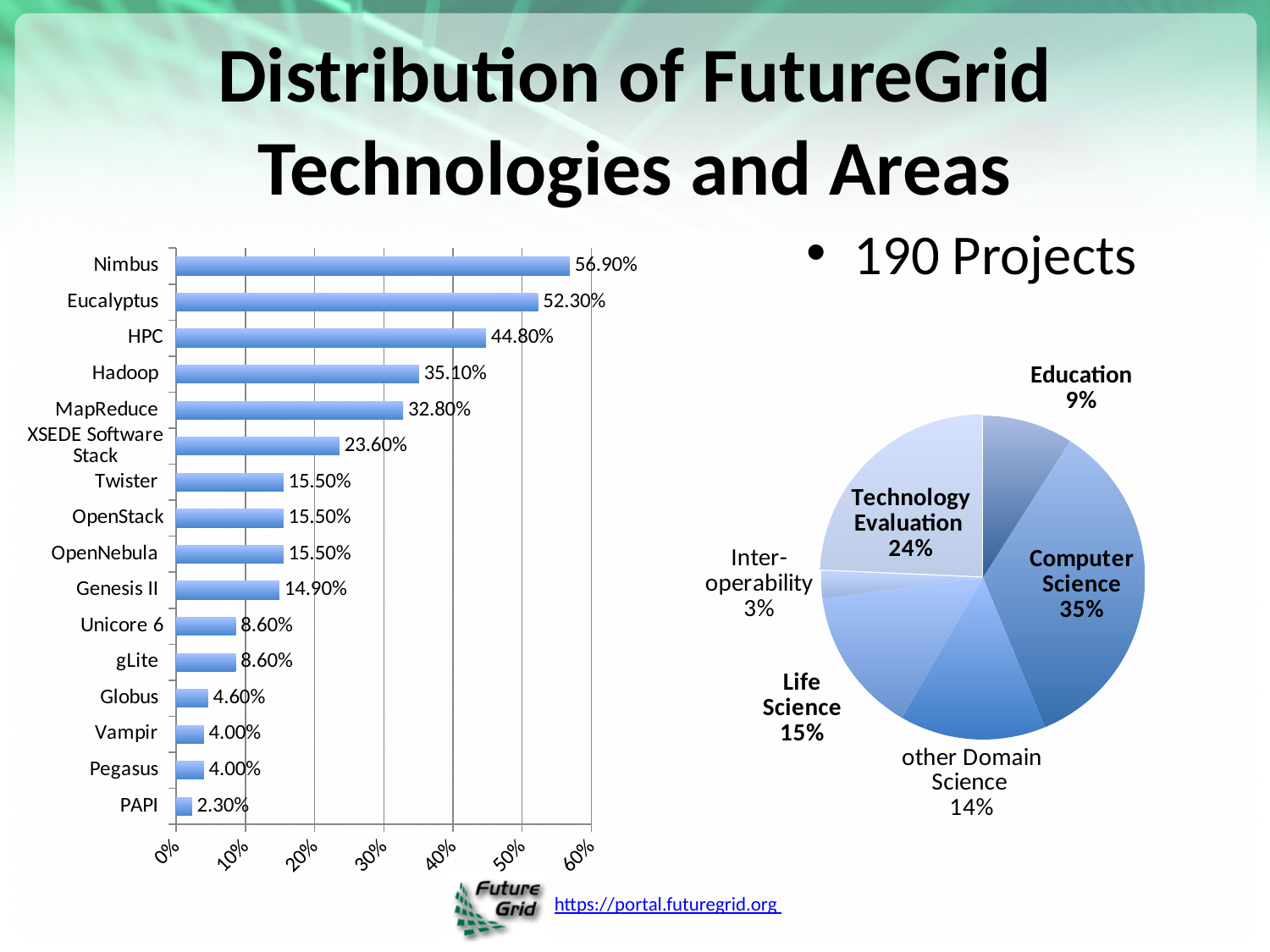
In the bar chart on the left, what is the value for Hadoop? 35.10% In the bar chart on the left, what is the value for XSEDE Software Stack? 23.60% In the bar chart on the left, what is the difference between the values for Nimbus and Eucalyptus? 4.60% In the pie chart on the right, what share does Computer Science have? 35% In the pie chart on the right, what is the difference between the shares of Technology Evaluation and Education? 15% How many technologies are shown in the bar chart on the left? 16 What kind of chart is the chart on the left of the slide? Bar chart In the pie chart on the right, which area has the smallest share? Interoperability In the bar chart on the left, which technology has the lowest value? PAPI In the bar chart on the left, which has a larger value, HPC or MapReduce? HPC How many slices does the pie chart on the right have? 6 In the bar chart on the left, which technology has the highest value? Nimbus